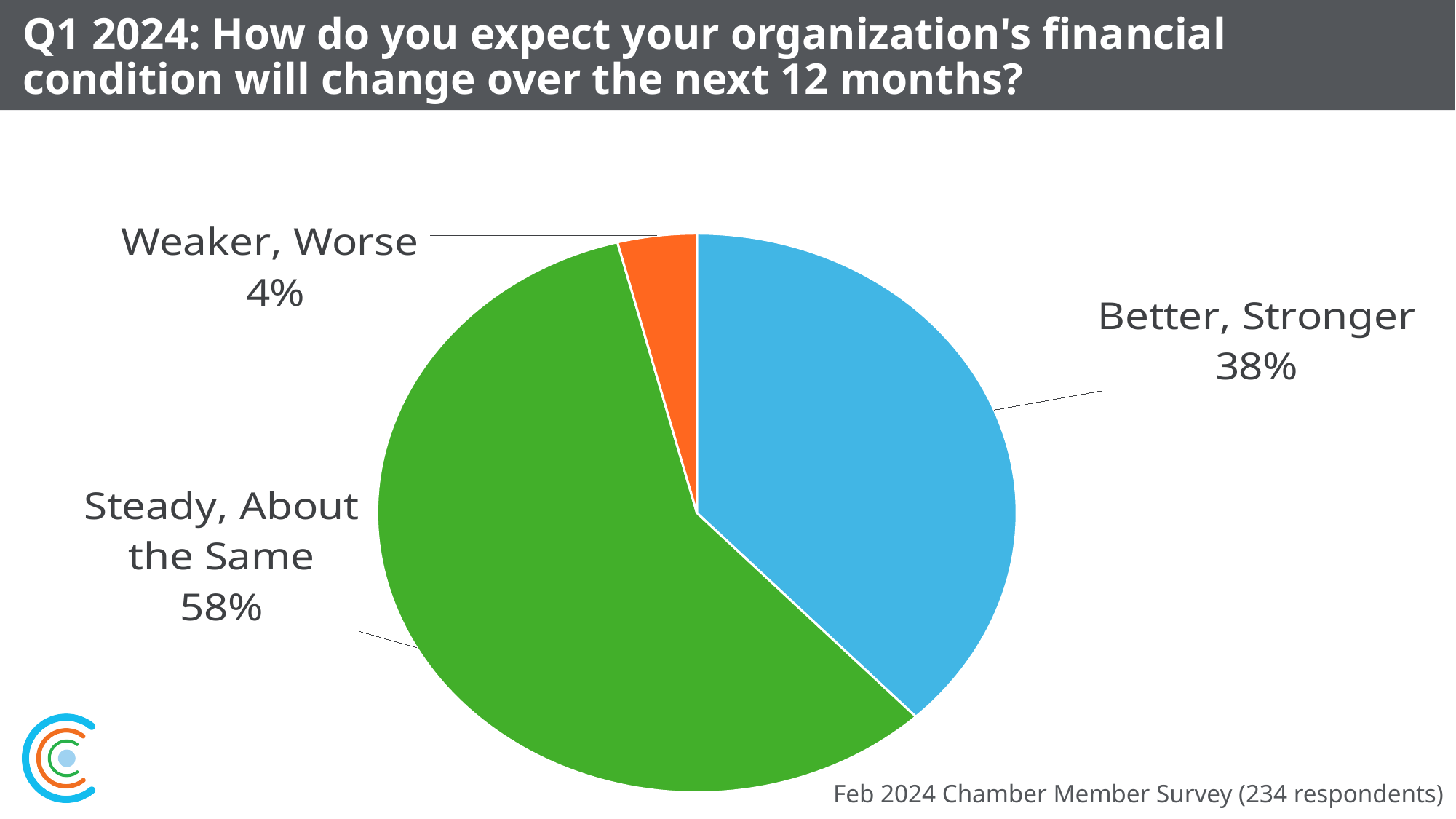
How many percentage points larger is the Steady, About the Same share than the Better, Stronger share? 20 What share of respondents expect their organization's financial condition to be Better, Stronger? 38% How many respondents does the survey note say took part? 234 What is the combined share of respondents expecting Better, Stronger or Steady, About the Same? 96% Which is larger: the share for Better, Stronger or the share for Weaker, Worse? Better, Stronger What kind of chart is shown on the slide? pie chart What share of respondents expect their organization's financial condition to be Weaker, Worse? 4% Which response has the largest share of the pie? Steady, About the Same What share of respondents expect their organization's financial condition to be Steady, About the Same? 58% What colour is the slice for Steady, About the Same? green Which response has the smallest share of the pie? Weaker, Worse How many slices does the pie chart have? 3